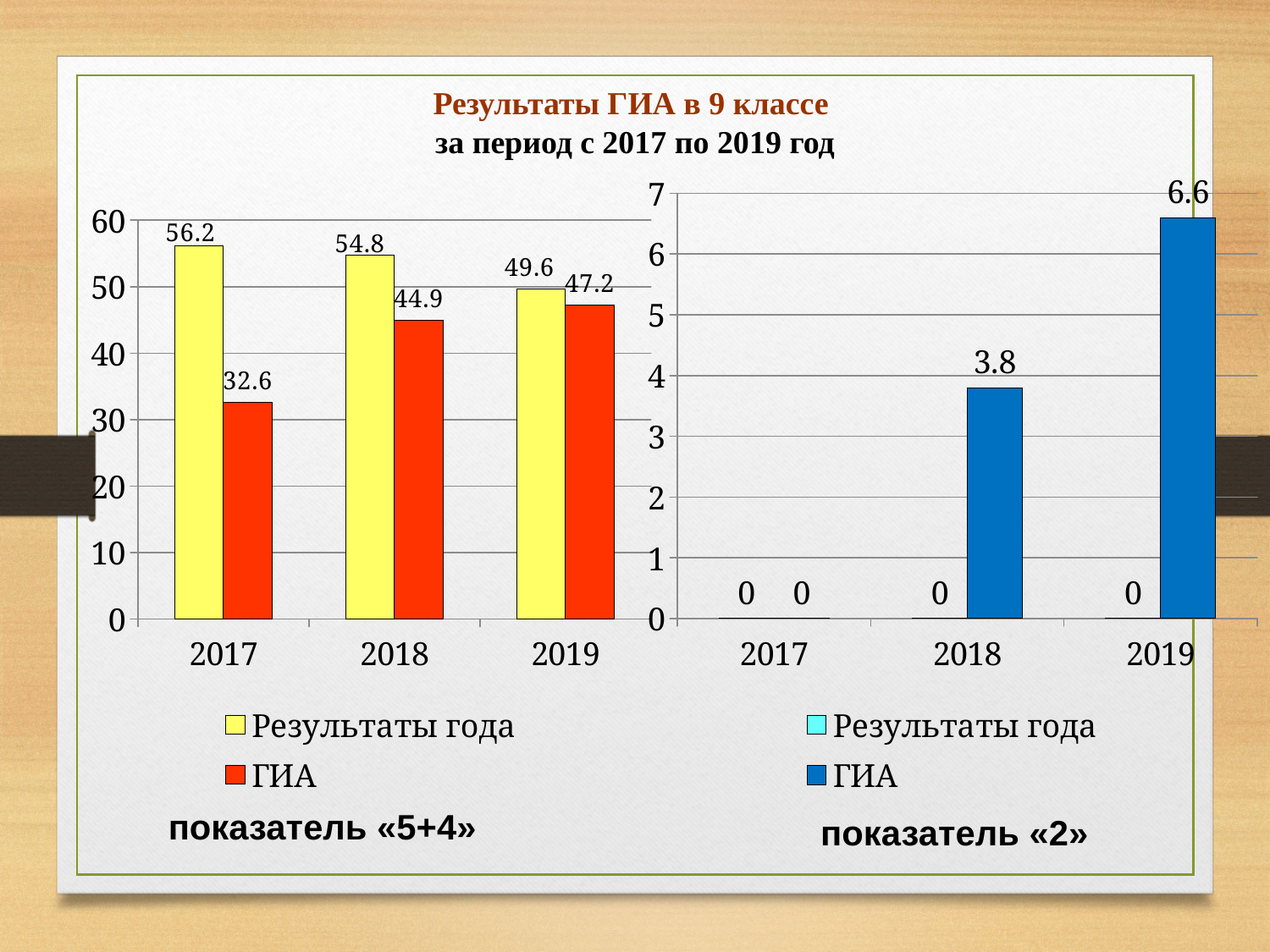
In the left chart (показатель «5+4»), what is the difference between Результаты года and ГИА in 2017? 23.6 In the left chart (показатель «5+4»), does the ГИА value rise or fall from 2017 to 2019? rise In the left chart (показатель «5+4»), what is the value of Результаты года for 2018? 54.8 In the left chart (показатель «5+4»), what is the value of ГИА for 2017? 32.6 In the left chart (показатель «5+4»), does the Результаты года value rise or fall from 2017 to 2019? fall In the right chart (показатель «2»), what is the value of ГИА for 2019? 6.6 In the left chart (показатель «5+4»), which is larger in 2019: Результаты года or ГИА? Результаты года In the left chart (показатель «5+4»), which year has the highest Результаты года value? 2017 How many series does the legend of the right chart (показатель «2») list? 2 What kind of chart is the left chart (показатель «5+4»)? bar chart In the right chart (показатель «2»), what is the difference between the ГИА values for 2019 and 2018? 2.8 In the left chart (показатель «5+4»), which year has the lowest ГИА value? 2017